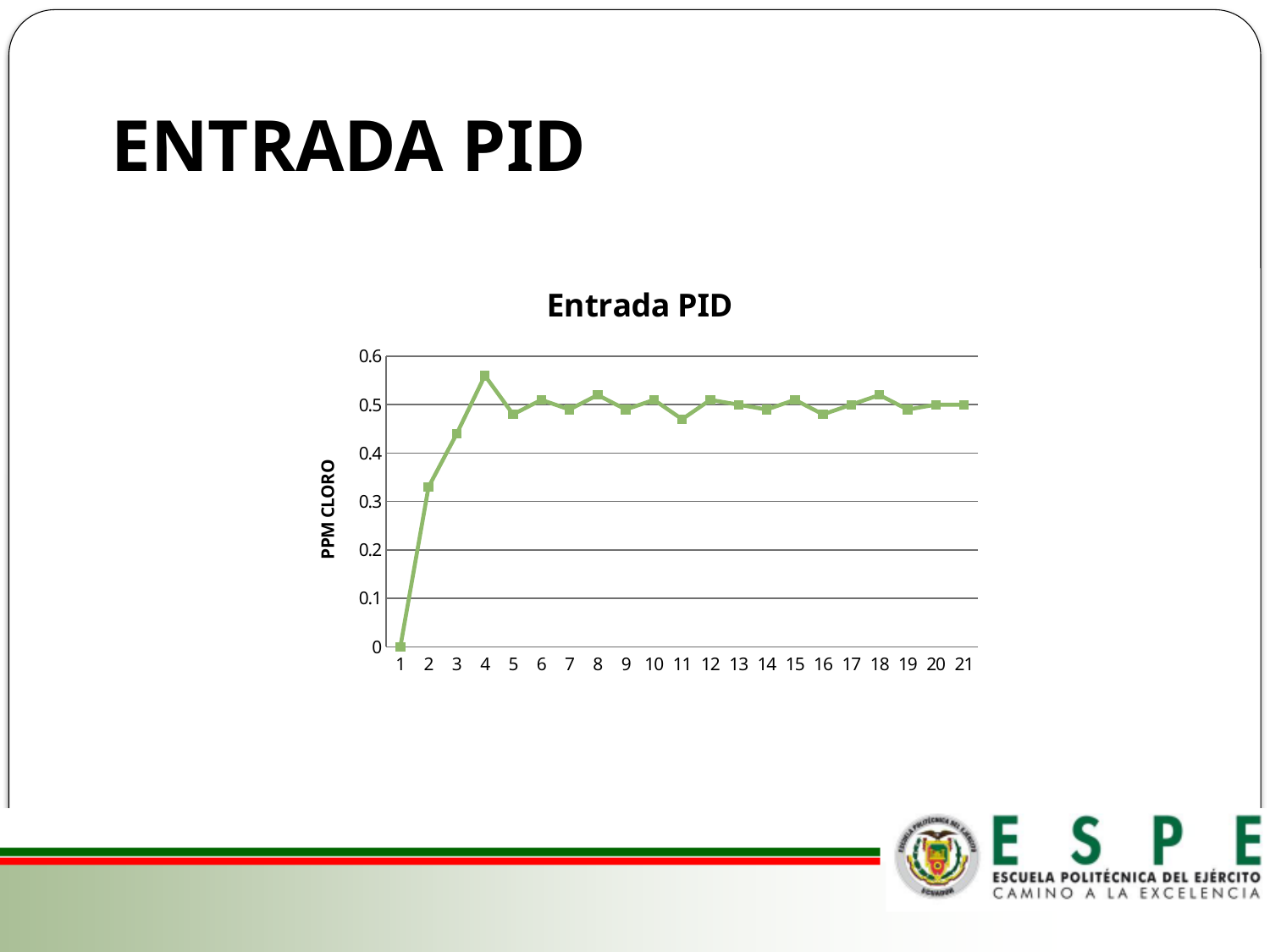
How many points are plotted along the x axis of the chart? 21 What is the label on the vertical axis of the chart? PPM CLORO Is the value at point 3 greater or less than 0.4? greater What kind of chart is shown on the slide? line chart Which point has the larger value, point 2 or point 4? 4 What is the value at point 1? 0 What is the title of the chart? Entrada PID Is the value at point 4 greater or less than 0.5? greater At which x-axis point does the line have its lowest value? 1 Do the values rise or fall from point 1 to point 4? rise Is the value at point 2 greater or less than 0.4? less At which x-axis point does the line reach its highest value? 4